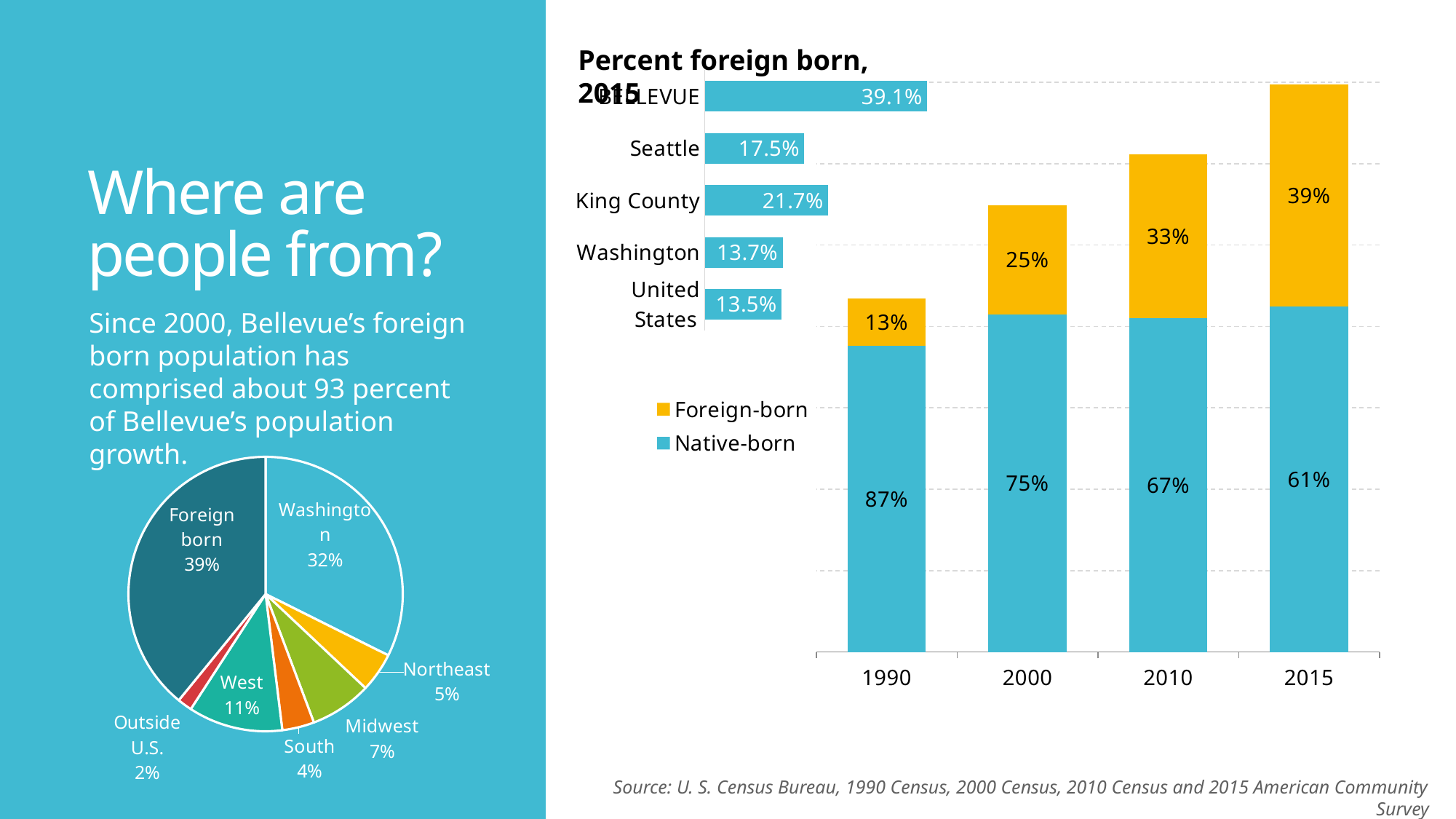
In the stacked bar chart by year, does the foreign-born share rise or fall from 1990 to 2015? Rise In the 'Percent foreign born, 2015' bar chart, which area has the lowest percent foreign born? United States In the pie chart on the left, what share is Washington? 32% In the stacked bar chart by year, which colour represents Foreign-born? Yellow/orange In the pie chart on the left, which slice is larger, West or Midwest? West In the 'Percent foreign born, 2015' bar chart, what is the value for Seattle? 17.5% In the 'Percent foreign born, 2015' bar chart, how many areas are shown? 5 In the 'Percent foreign born, 2015' bar chart, what is the difference between King County and Washington? 8.0 percentage points In the stacked bar chart by year, how many series does the legend list? 2 In the stacked bar chart by year, what is the native-born share in 1990? 87% In the stacked bar chart by year, what is the foreign-born share in 2010? 33% In the 'Percent foreign born, 2015' bar chart, which area has the highest percent foreign born? Bellevue